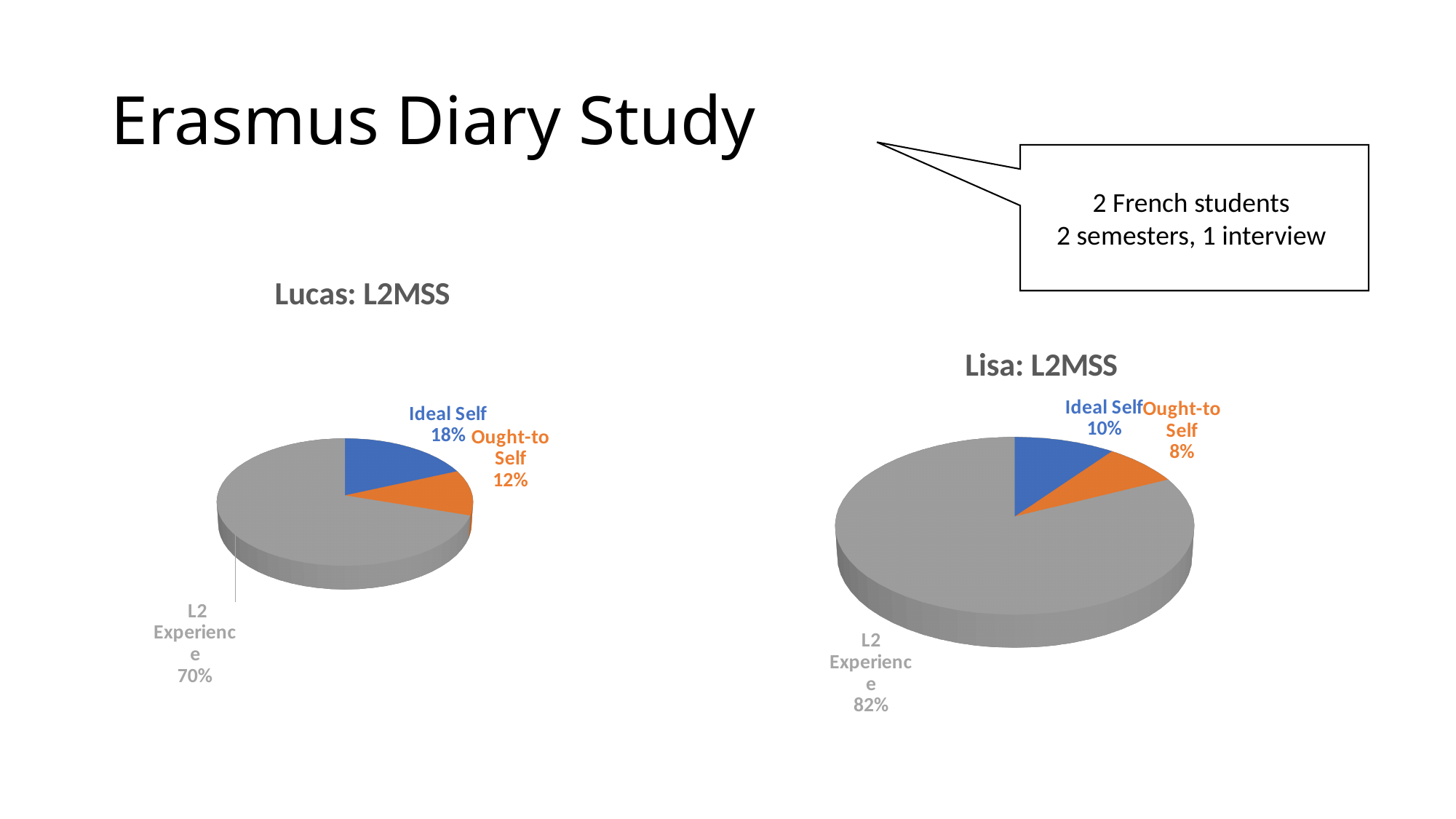
What kind of chart is the 'Lucas: L2MSS' chart? Pie chart In the 'Lucas: L2MSS' chart, what is the value for Ideal Self? 18% Which is larger: Ideal Self in the 'Lucas: L2MSS' chart or Ideal Self in the 'Lisa: L2MSS' chart? Lucas: L2MSS How many categories does the 'Lisa: L2MSS' chart show? 3 In the 'Lisa: L2MSS' chart, what share does L2 Experience have? 82% In the 'Lucas: L2MSS' chart, which category has the largest slice? L2 Experience In the 'Lucas: L2MSS' chart, what share does L2 Experience have? 70% In the 'Lucas: L2MSS' chart, what is the difference between Ideal Self and Ought-to Self? 6% In the 'Lucas: L2MSS' chart, what is the value for Ought-to Self? 12% In the 'Lisa: L2MSS' chart, which category has the smallest slice? Ought-to Self In the 'Lisa: L2MSS' chart, what is the value for Ought-to Self? 8% In the 'Lisa: L2MSS' chart, what is the value for Ideal Self? 10%